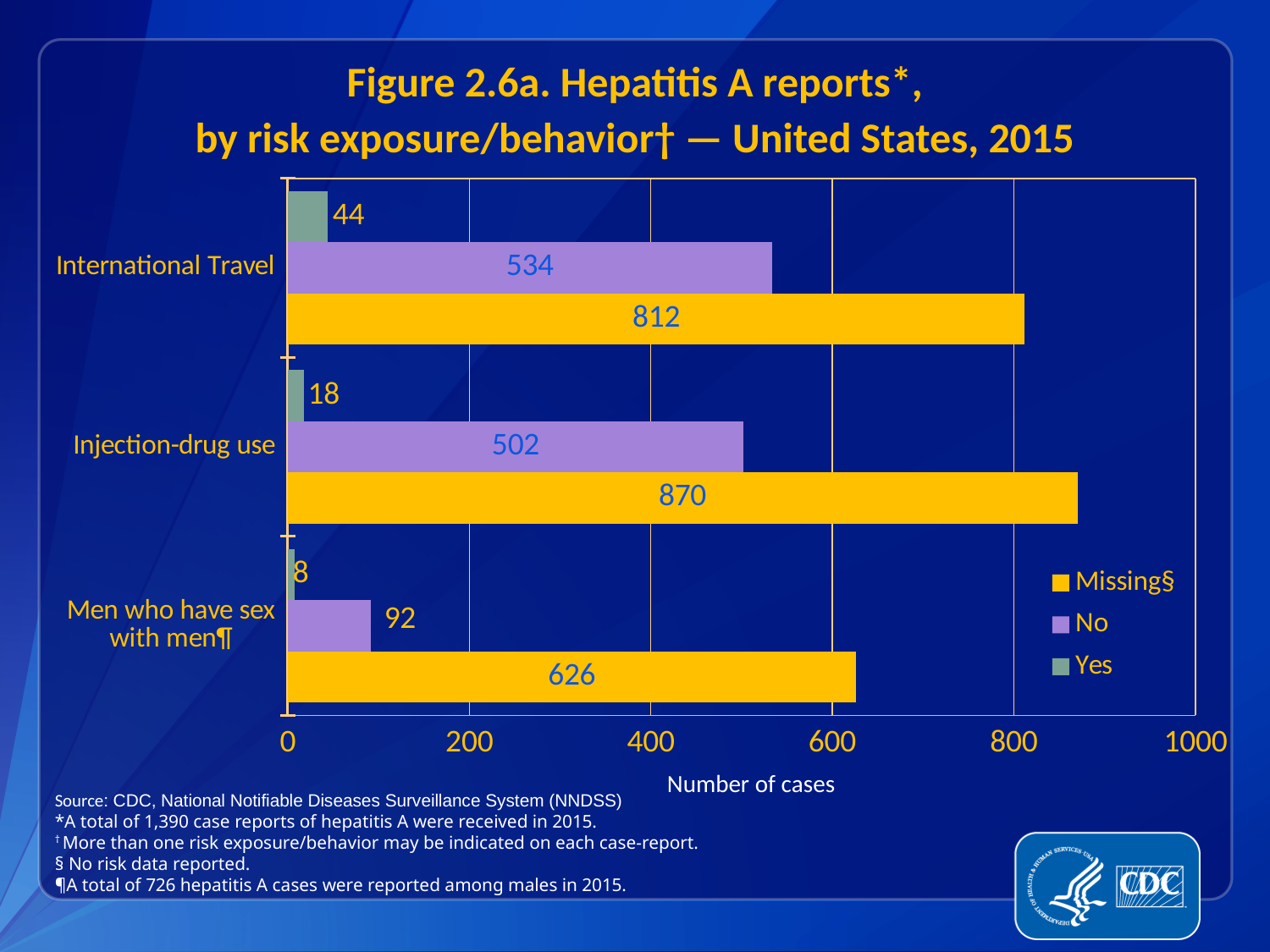
What is the number of cases with 'Yes' for International Travel? 44 How many series does the legend list? 3 How many risk exposure/behavior categories are shown on the chart? 3 What is the difference between the 'No' values for International Travel and Injection-drug use? 32 What is the number of cases with 'Missing' for Injection-drug use? 870 What is the number of cases with 'No' for Men who have sex with men? 92 What is the label of the x axis? Number of cases What kind of chart is shown on the slide? Bar chart Which risk exposure/behavior has the highest 'Missing' value? Injection-drug use Is the 'No' value for Injection-drug use greater or less than 400? greater Which risk exposure/behavior has the lowest 'Yes' value? Men who have sex with men Which is larger: the 'Missing' value for International Travel or the 'Missing' value for Men who have sex with men? International Travel